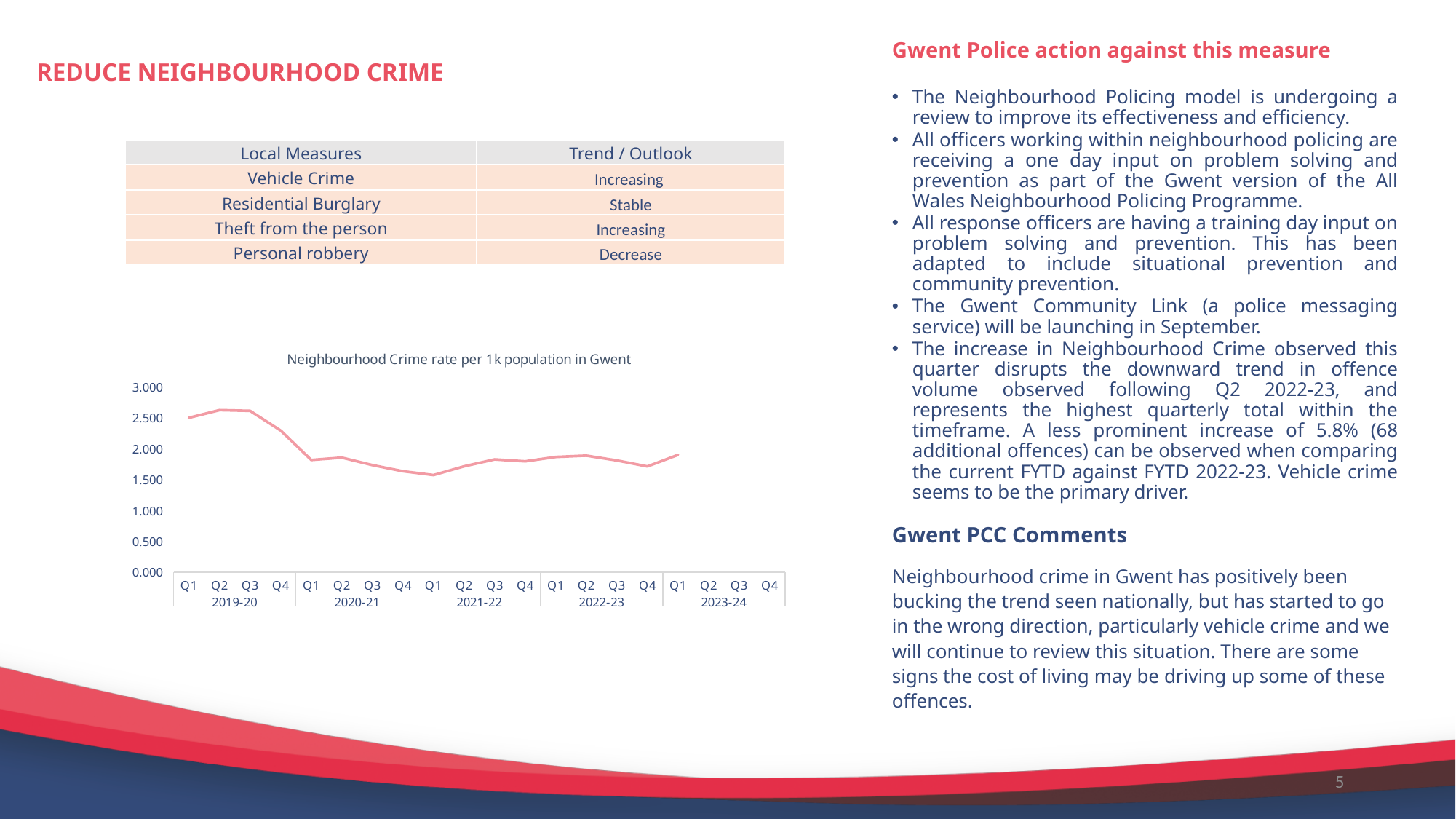
Does the crime rate rise or fall between Q4 2022-23 and Q1 2023-24? rise Is the value for Q1 2019-20 greater or less than 2.000? greater Which is larger, the value for Q1 2019-20 or the value for Q1 2020-21? Q1 2019-20 What is the title of the chart? Neighbourhood Crime rate per 1k population in Gwent Which quarter has the lowest neighbourhood crime rate on the chart? Q1 2021-22 Is the value for Q1 2020-21 greater or less than 2.000? less Is the value for Q1 2023-24 greater or less than 2.500? less Does the crime rate rise or fall between Q3 2019-20 and Q1 2020-21? fall What kind of chart is shown on the slide? line chart What is the highest value shown on the y axis? 3.000 How many financial years are labelled on the x axis? 5